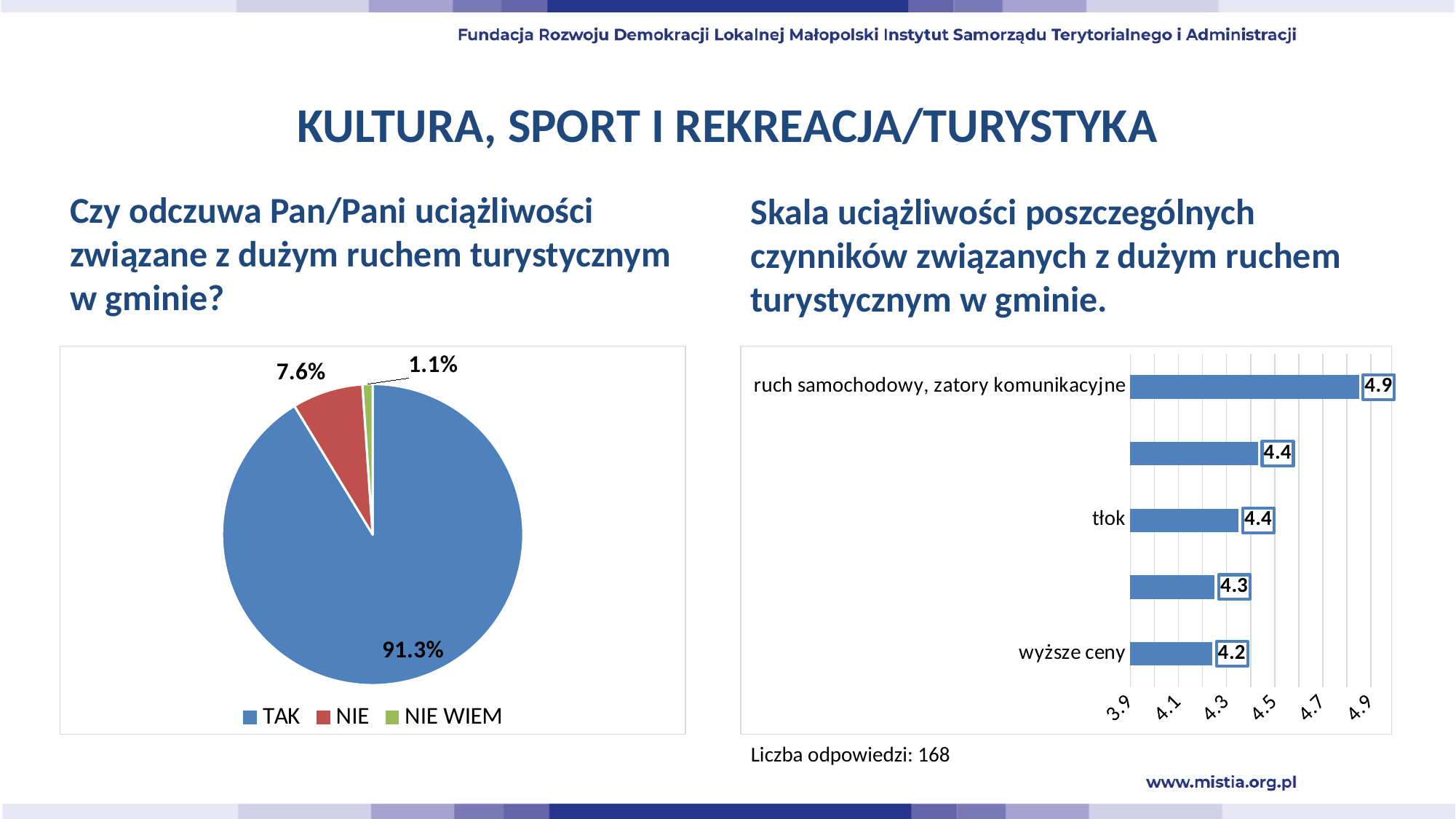
What type of chart is shown on the left side of the slide? Pie chart In the bar chart on the right, how many bars are plotted? 5 In the pie chart on the left, what share of respondents answered TAK? 91.3% In the bar chart on the right, what is the value for 'tłok'? 4.4 In the pie chart on the left, which answer has the largest share? TAK In the bar chart on the right, what is the value for 'wyższe ceny'? 4.2 In the pie chart on the left, how many entries does the legend list? 3 In the pie chart on the left, which answer has the smallest share? NIE WIEM In the bar chart on the right, what is the difference between the values for 'ruch samochodowy, zatory komunikacyjne' and 'wyższe ceny'? 0.7 In the bar chart on the right, what is the value for 'ruch samochodowy, zatory komunikacyjne'? 4.9 In the pie chart on the left, what share of respondents answered NIE WIEM? 1.1% In the pie chart on the left, what share of respondents answered NIE? 7.6%